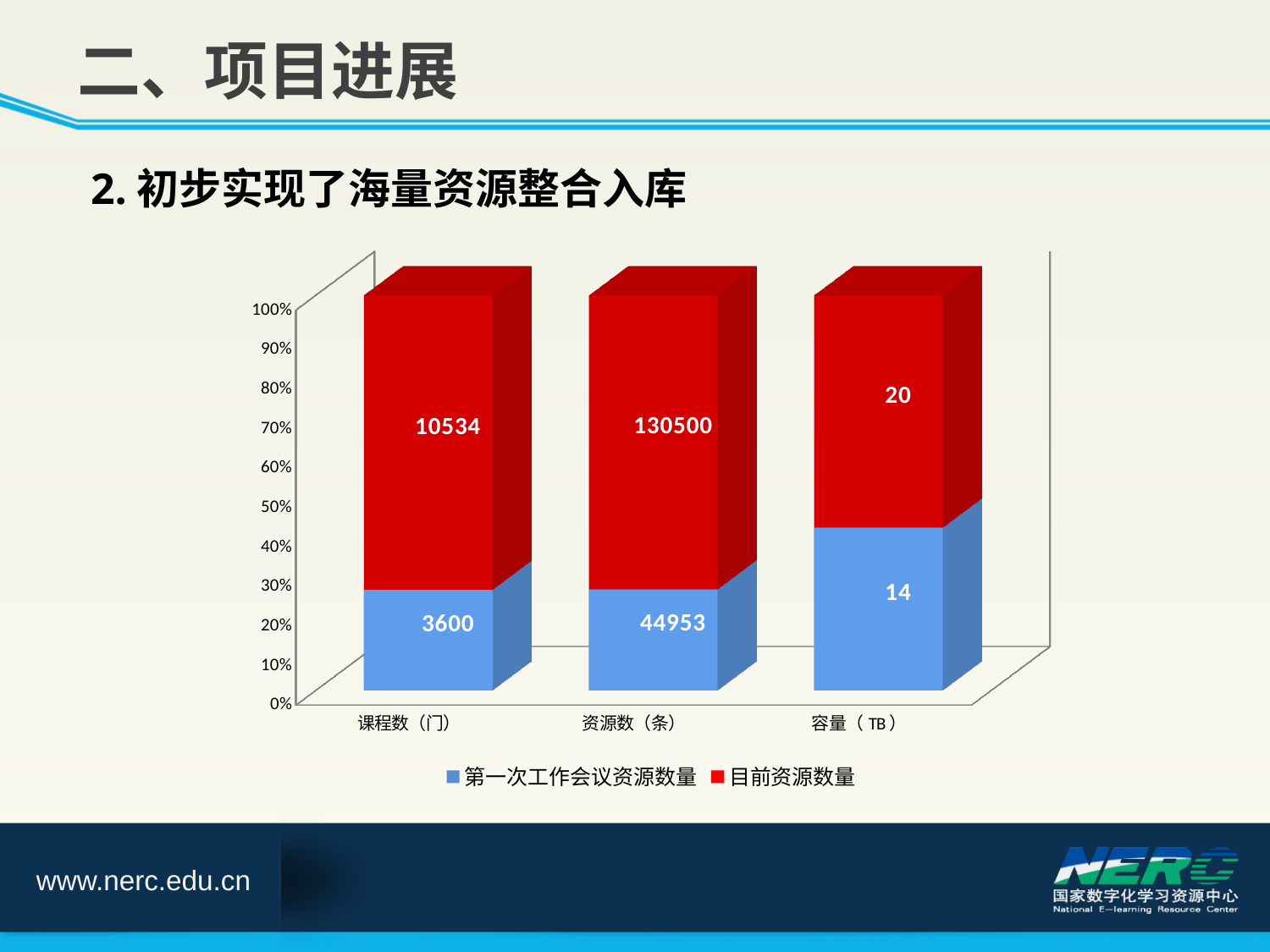
What is the value of 目前资源数量 for 课程数（门）? 10534 How many categories are shown on the x axis? 3 What is the value of 第一次工作会议资源数量 for 资源数（条）? 44953 Which is larger for 资源数（条）: 第一次工作会议资源数量 or 目前资源数量? 目前资源数量 What is the value of 目前资源数量 for 容量（TB）? 20 How many series does the legend list? 2 What is the total of the two stacked values for 容量（TB）? 34 Which colour represents 目前资源数量 in the chart? Red What is the difference between 目前资源数量 and 第一次工作会议资源数量 for 容量（TB）? 6 What kind of chart is shown on the slide? Stacked bar chart What is the difference between 目前资源数量 and 第一次工作会议资源数量 for 课程数（门）? 6934 What is the value of 第一次工作会议资源数量 for 课程数（门）? 3600